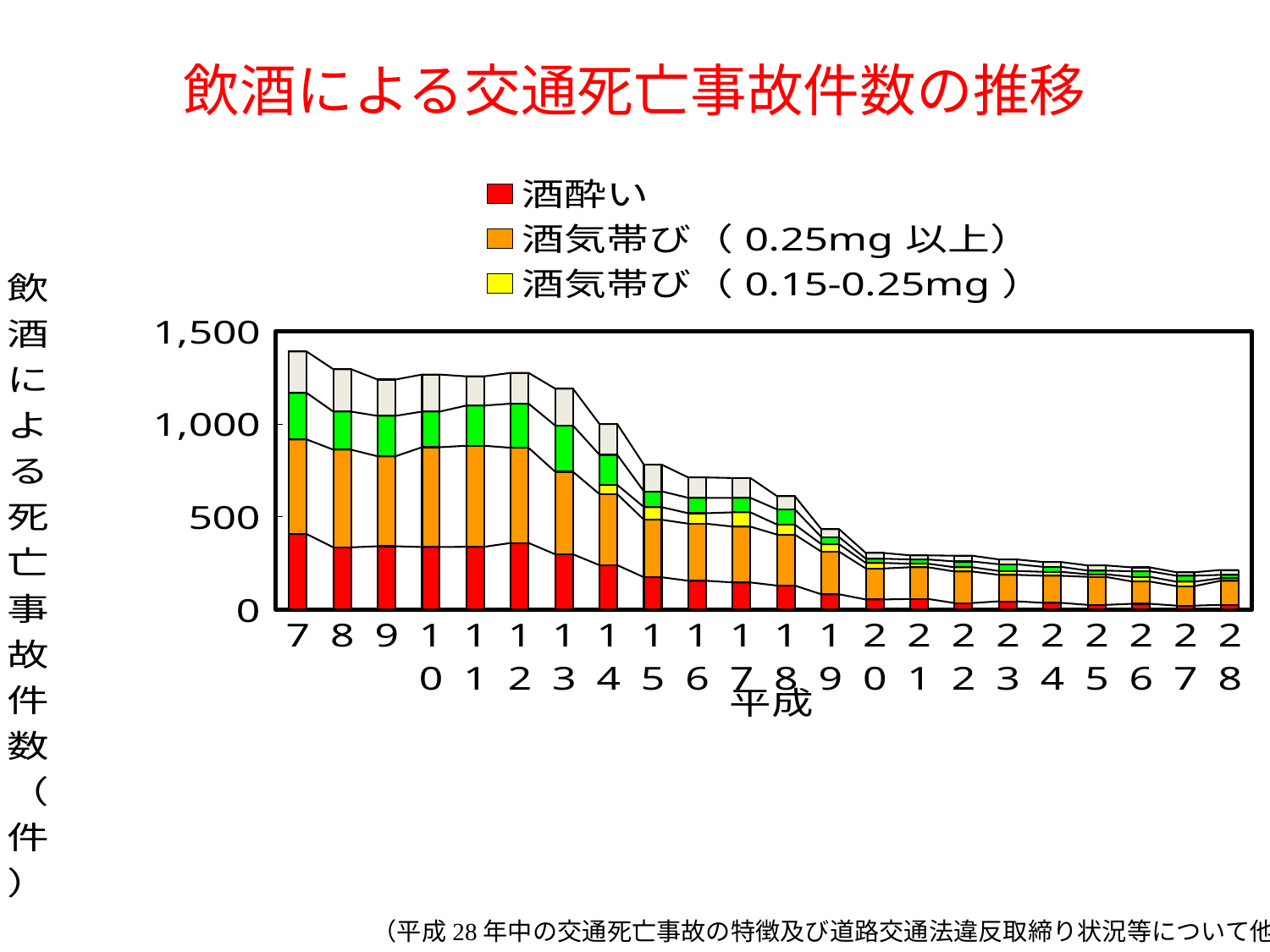
Is the total value for Heisei 7 greater or less than 1,000? greater How many series does the legend list? 3 Which has the larger total, Heisei 12 or Heisei 15? Heisei 12 What is the title of the chart? 飲酒による交通死亡事故件数の推移 What kind of chart is shown on the slide? stacked bar chart Is the 酒酔い (red) value for Heisei 7 greater or less than 500? less Which legend entry is shown in red? 酒酔い Is the total value for Heisei 28 greater or less than 500? less Which year has the highest total number of accidents? Heisei 7 Do the total values rise or fall from Heisei 7 to Heisei 28? fall How many years (bars) are plotted along the x axis? 22